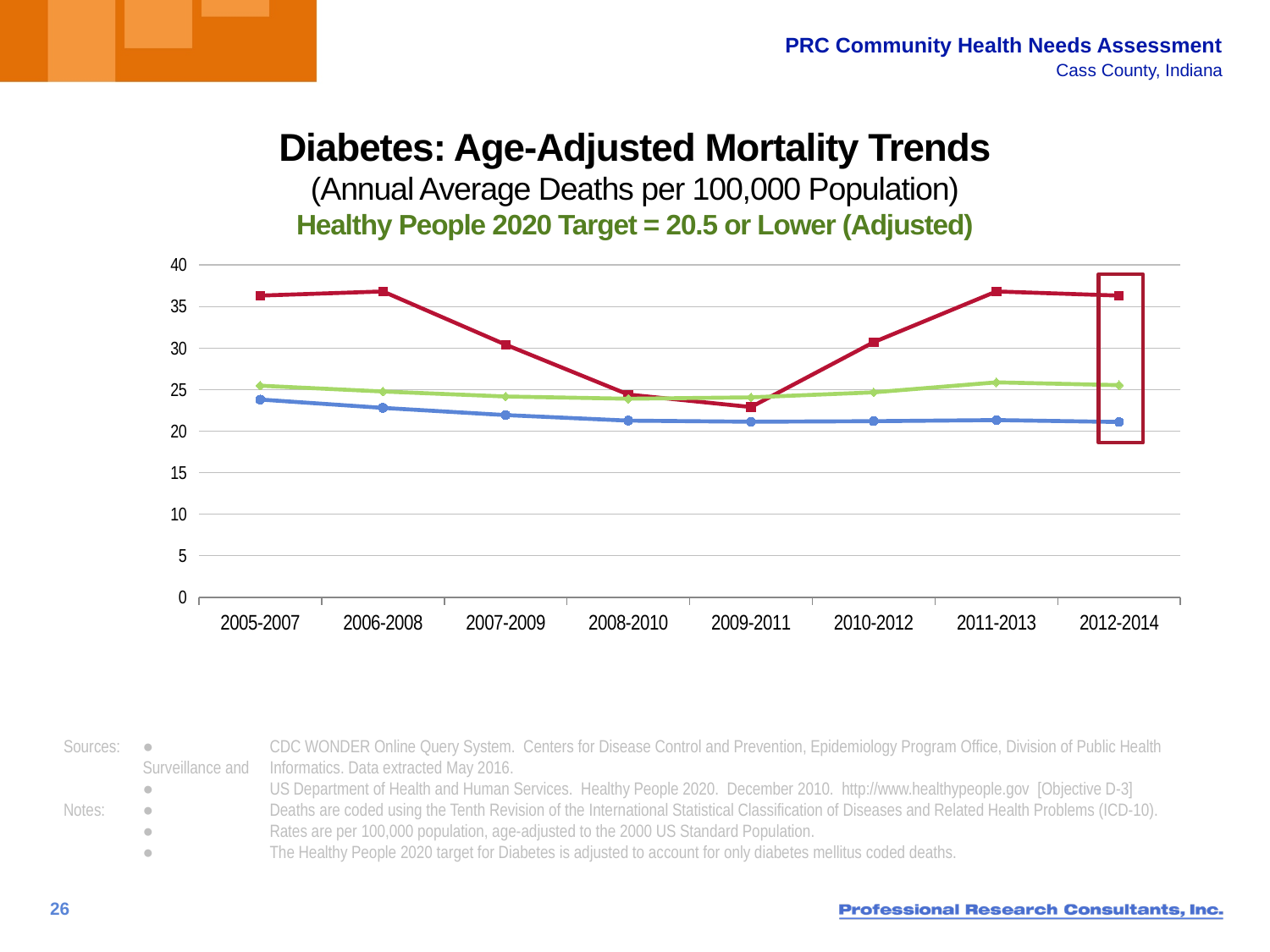
Is the value of the red line for 2007-2009 greater or less than 25? greater Is the value of the red line for 2005-2007 greater or less than 35? greater What kind of chart is shown on the slide? line chart Is the value of the blue line for 2012-2014 greater or less than 25? less In 2005-2007, which line has the higher value, the red line or the blue line? the red line What is the Healthy People 2020 target stated in the chart subtitle? 20.5 or Lower (Adjusted) In which period does the red line reach its lowest value? 2009-2011 Which period is the last one shown on the x axis? 2012-2014 How many time periods are shown on the x axis of the chart? 8 What is the title of the chart? Diabetes: Age-Adjusted Mortality Trends Does the blue line rise or fall from 2005-2007 to 2012-2014? fall